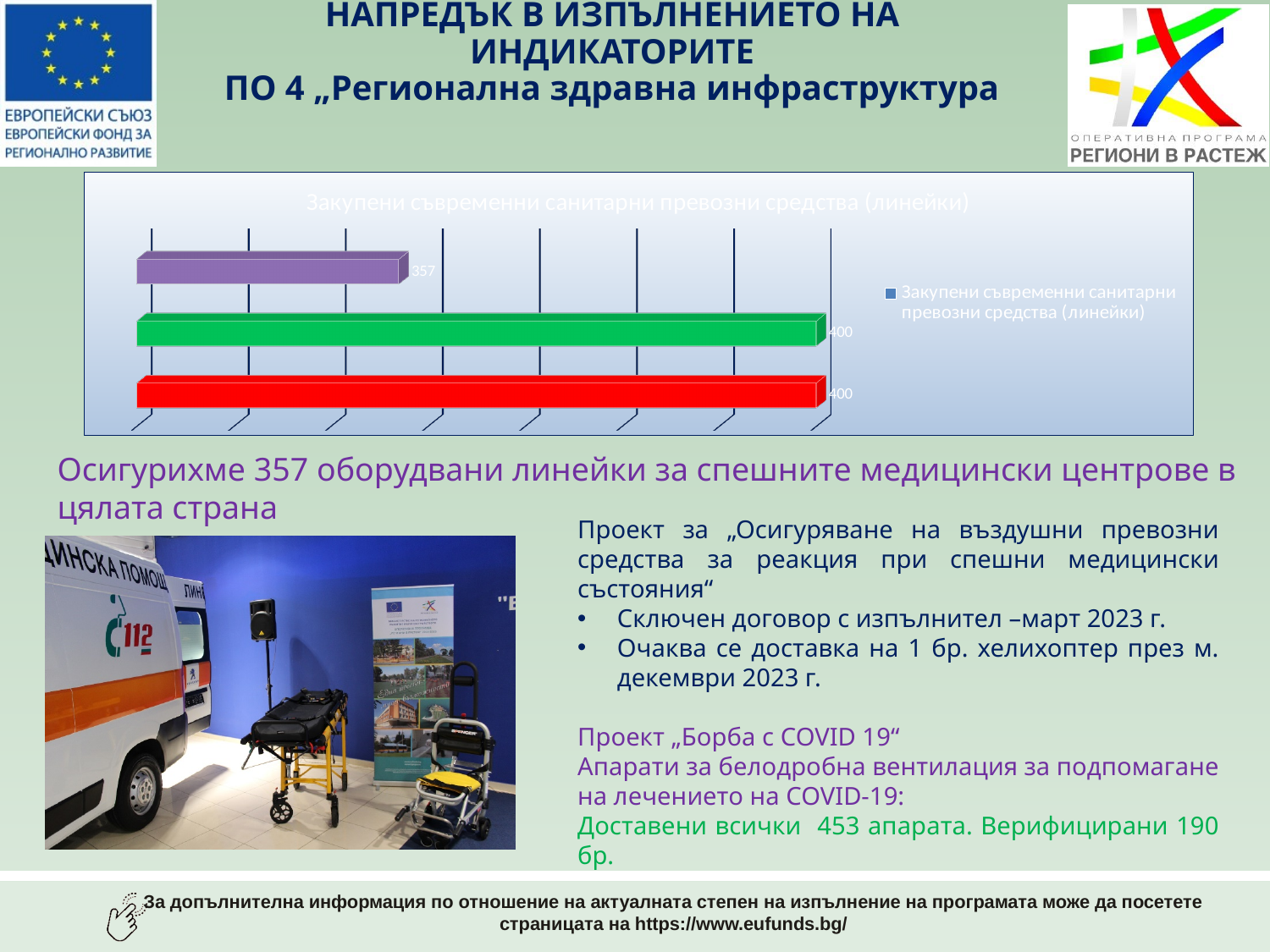
What is the value of the green (middle) bar in the chart? 400 What is the value of the purple (top) bar in the chart? 357 Is the value of the purple bar greater or less than 400? less What colour is the bar with the value 357? purple How many bars does the chart show? 3 What is the legend entry shown in the chart? Закупени съвременни санитарни превозни средства (линейки) Which is larger, the value of the red bar or the value of the purple bar? the red bar Which bar has the lowest value in the chart? the purple (top) bar What is the difference between the green bar's value and the purple bar's value? 43 What kind of chart is shown on the slide? bar chart What is the value of the red (bottom) bar in the chart? 400 How many series does the chart legend list? 1